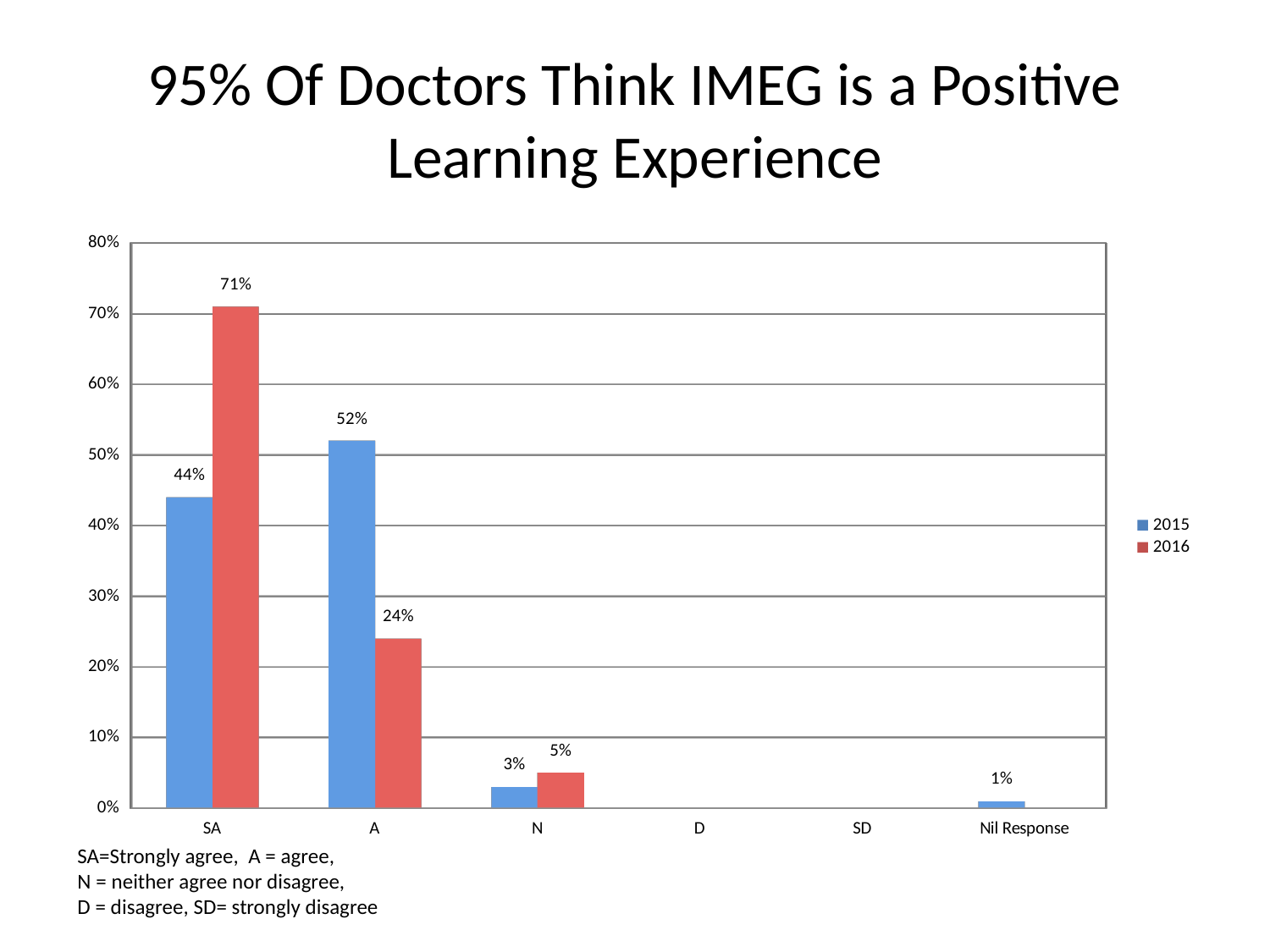
What is the value for A in the 2015 series? 52% What is the difference between the 2015 and 2016 values for A? 28% What is the value for SA in the 2016 series? 71% What is the value for Nil Response in the 2015 series? 1% What is the value for N in the 2016 series? 5% What is the difference between the 2016 and 2015 values for SA? 27% Which category has the highest value in the 2016 series? SA How many categories are shown on the x axis? 6 Which category has the highest value in the 2015 series? A Which is larger for N: the 2015 value or the 2016 value? 2016 What kind of chart is shown on the slide? Bar chart How many series does the legend list? 2